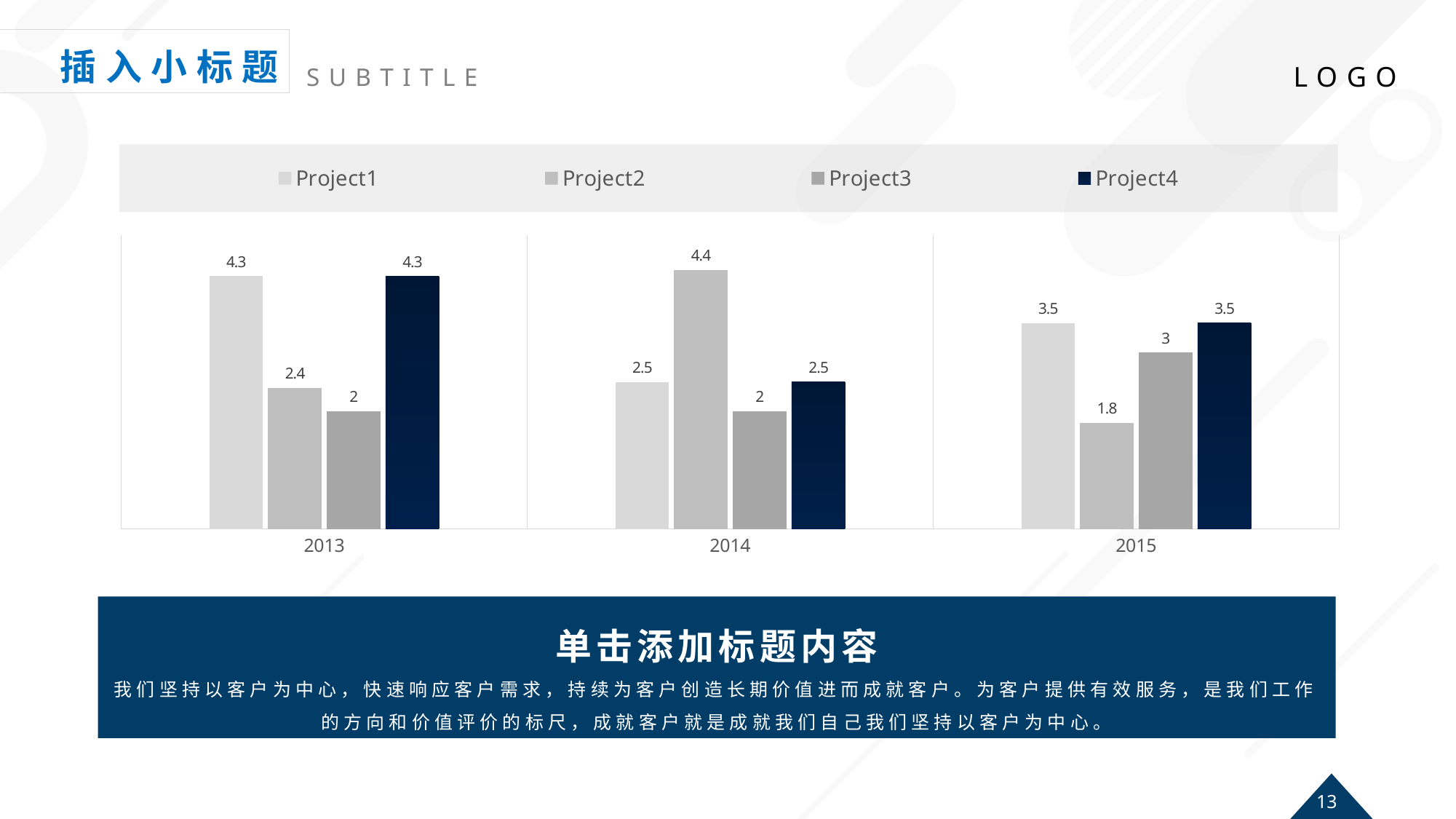
What is the difference between Project2 and Project3 in 2014? 2.4 What is the value for Project3 in 2015? 3 Which series has the lowest value in 2015? Project2 How many categories are shown on the x axis? 3 Which series is shown in dark navy blue in the legend? Project4 Which is larger, Project1 in 2013 or Project1 in 2014? Project1 in 2013 What is the value for Project1 in 2013? 4.3 What is the value for Project2 in 2014? 4.4 What is the value for Project2 in 2015? 1.8 What kind of chart is shown on the slide? Bar chart How many series does the legend list? 4 Which series has the highest value in 2014? Project2